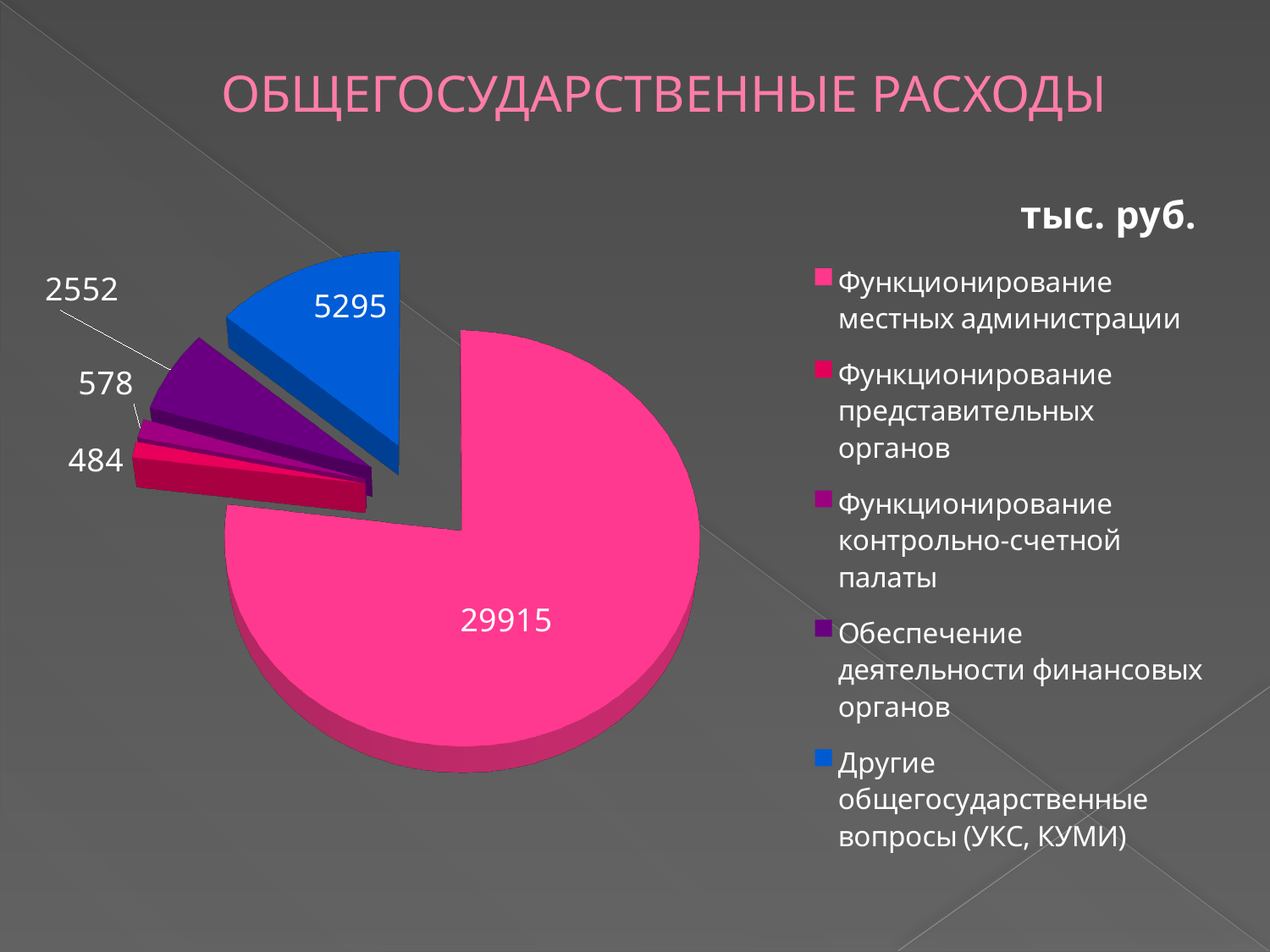
What type of chart is shown on the slide? pie chart What is the value for Функционирование представительных органов? 484 Which category has the largest slice? Функционирование местных администрации Which category has the smallest slice? Функционирование представительных органов What unit is stated above the legend? тыс. руб. What is the value for Функционирование местных администрации? 29915 What is the value for Другие общегосударственные вопросы (УКС, КУМИ)? 5295 What is the value for Функционирование контрольно-счетной палаты? 578 What is the difference between the values for Другие общегосударственные вопросы (УКС, КУМИ) and Обеспечение деятельности финансовых органов? 2743 Which is larger: Функционирование контрольно-счетной палаты or Функционирование представительных органов? Функционирование контрольно-счетной палаты How many slices does the pie chart have? 5 What is the value for Обеспечение деятельности финансовых органов? 2552